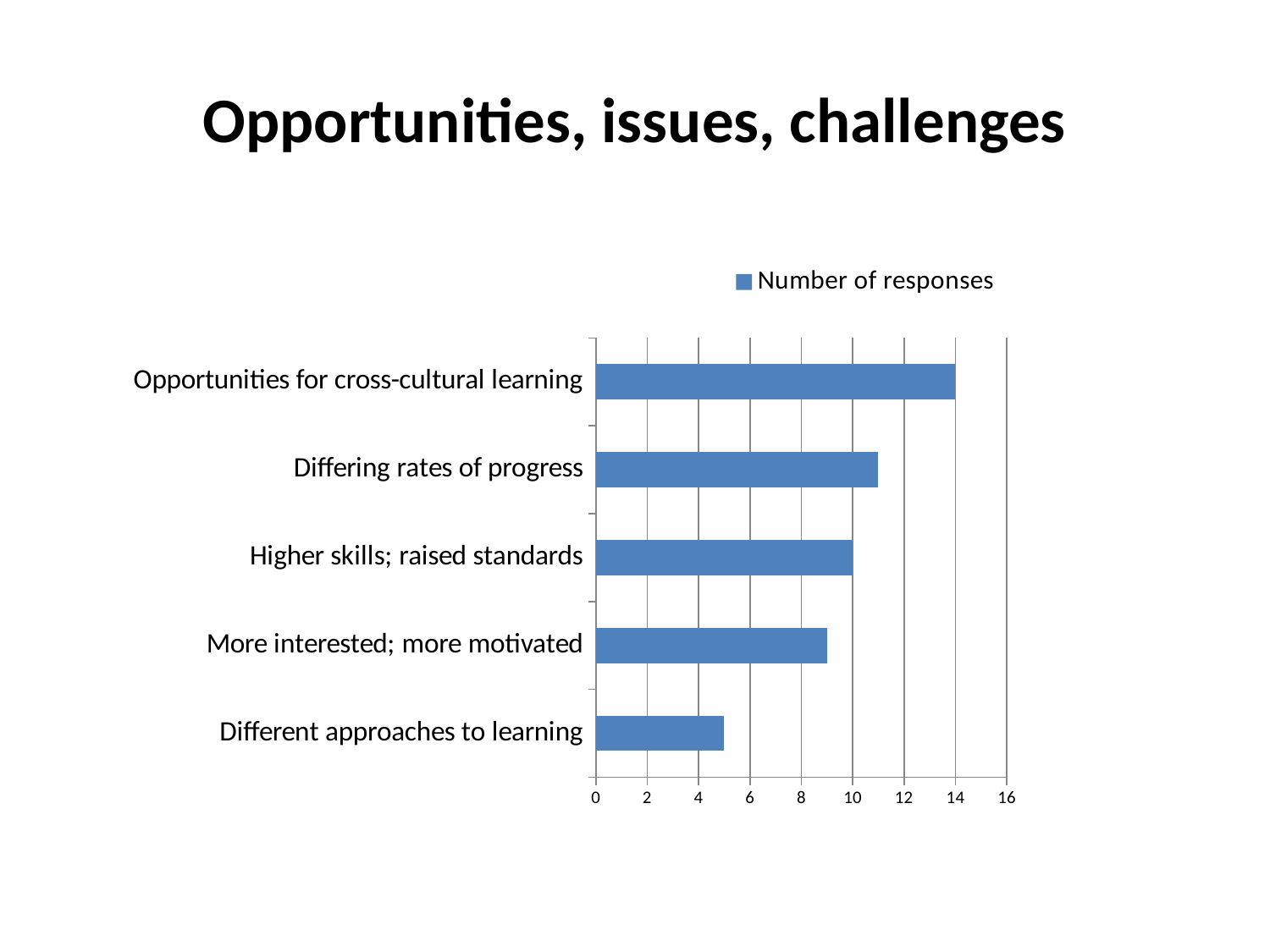
Which has more responses: Differing rates of progress or More interested; more motivated? Differing rates of progress How many categories are plotted in the chart? 5 What is the name of the series shown in the legend? Number of responses Is the value for Differing rates of progress greater or less than 10? greater Which category has the lowest number of responses? Different approaches to learning Is the value for Different approaches to learning greater or less than 6? less What is the number of responses for Higher skills; raised standards? 10 What kind of chart is shown on the slide? bar chart Which category has the highest number of responses? Opportunities for cross-cultural learning How many series does the legend list? 1 Is the value for More interested; more motivated greater or less than 10? less What is the number of responses for Opportunities for cross-cultural learning? 14